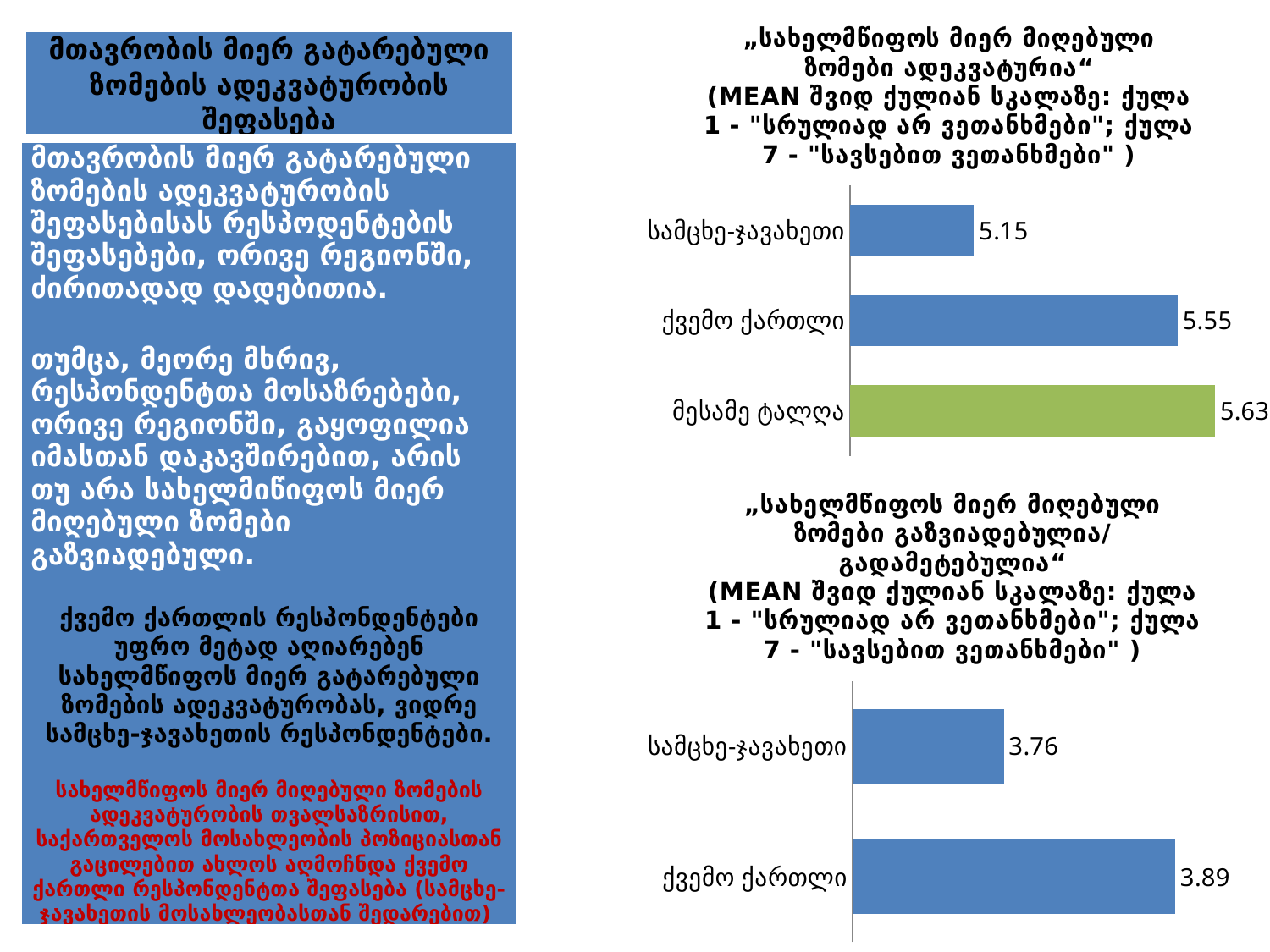
What type of chart is the bottom chart ("სახელმწიფოს მიერ მიღებული ზომები გაზვიადებულია/გადამეტებულია")? Bar chart In the top chart ("სახელმწიფოს მიერ მიღებული ზომები ადეკვატურია"), what is the value for მესამე ტალღა? 5.63 In the top chart ("სახელმწიფოს მიერ მიღებული ზომები ადეკვატურია"), what is the value for ქვემო ქართლი? 5.55 In the top chart ("სახელმწიფოს მიერ მიღებული ზომები ადეკვატურია"), which category has the lowest value? სამცხე-ჯავახეთი In the bottom chart ("სახელმწიფოს მიერ მიღებული ზომები გაზვიადებულია/გადამეტებულია"), what is the value for ქვემო ქართლი? 3.89 In the bottom chart ("სახელმწიფოს მიერ მიღებული ზომები გაზვიადებულია/გადამეტებულია"), which category has the larger value, სამცხე-ჯავახეთი or ქვემო ქართლი? ქვემო ქართლი How many categories are shown in the top chart ("სახელმწიფოს მიერ მიღებული ზომები ადეკვატურია")? 3 In the bottom chart ("სახელმწიფოს მიერ მიღებული ზომები გაზვიადებულია/გადამეტებულია"), what is the difference between the values for ქვემო ქართლი and სამცხე-ჯავახეთი? 0.13 In the bottom chart ("სახელმწიფოს მიერ მიღებული ზომები გაზვიადებულია/გადამეტებულია"), what is the value for სამცხე-ჯავახეთი? 3.76 In the top chart ("სახელმწიფოს მიერ მიღებული ზომები ადეკვატურია"), what is the difference between the values for ქვემო ქართლი and სამცხე-ჯავახეთი? 0.40 In the top chart ("სახელმწიფოს მიერ მიღებული ზომები ადეკვატურია"), which category has the highest value? მესამე ტალღა In the top chart ("სახელმწიფოს მიერ მიღებული ზომები ადეკვატურია"), what is the value for სამცხე-ჯავახეთი? 5.15